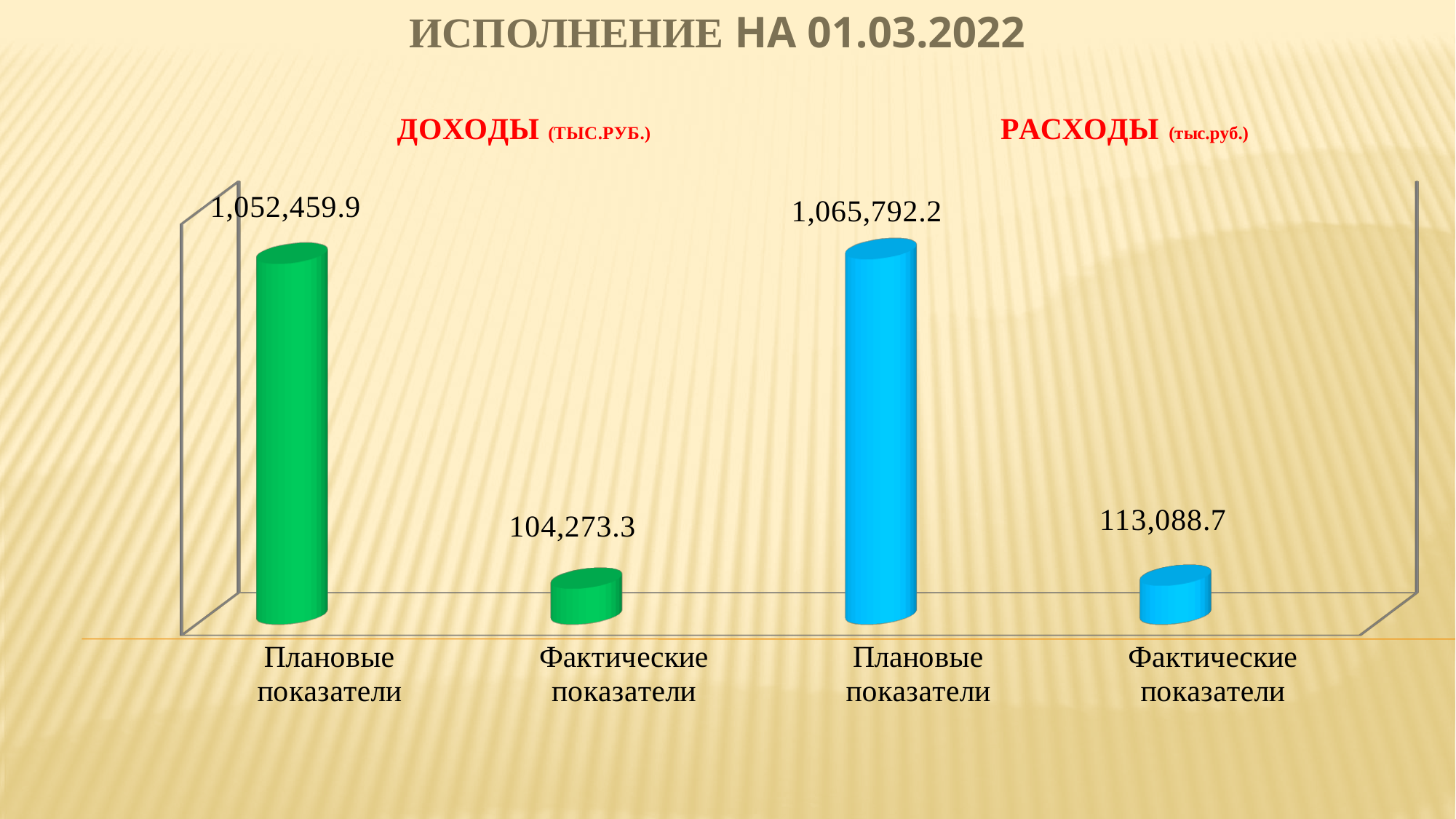
What is the difference between the planned and actual indicators under ДОХОДЫ? 948,186.6 What unit is stated next to the ДОХОДЫ and РАСХОДЫ headings? тыс.руб. What is the value of the actual indicators (Фактические показатели) bar under ДОХОДЫ? 104,273.3 Which bar has the lowest value on the chart? Фактические показатели under ДОХОДЫ (104,273.3) What is the value of the actual indicators (Фактические показатели) bar under РАСХОДЫ? 113,088.7 Which is larger: the actual indicators under ДОХОДЫ or the actual indicators under РАСХОДЫ? Actual indicators under РАСХОДЫ (113,088.7) What type of chart is shown on the slide? Bar chart What is the value of the planned indicators (Плановые показатели) bar under ДОХОДЫ? 1,052,459.9 What is the difference between the planned and actual indicators under РАСХОДЫ? 952,703.5 What is the value of the planned indicators (Плановые показатели) bar under РАСХОДЫ? 1,065,792.2 Which bar has the highest value on the chart? Плановые показатели under РАСХОДЫ (1,065,792.2) How many bars are plotted on the chart? 4